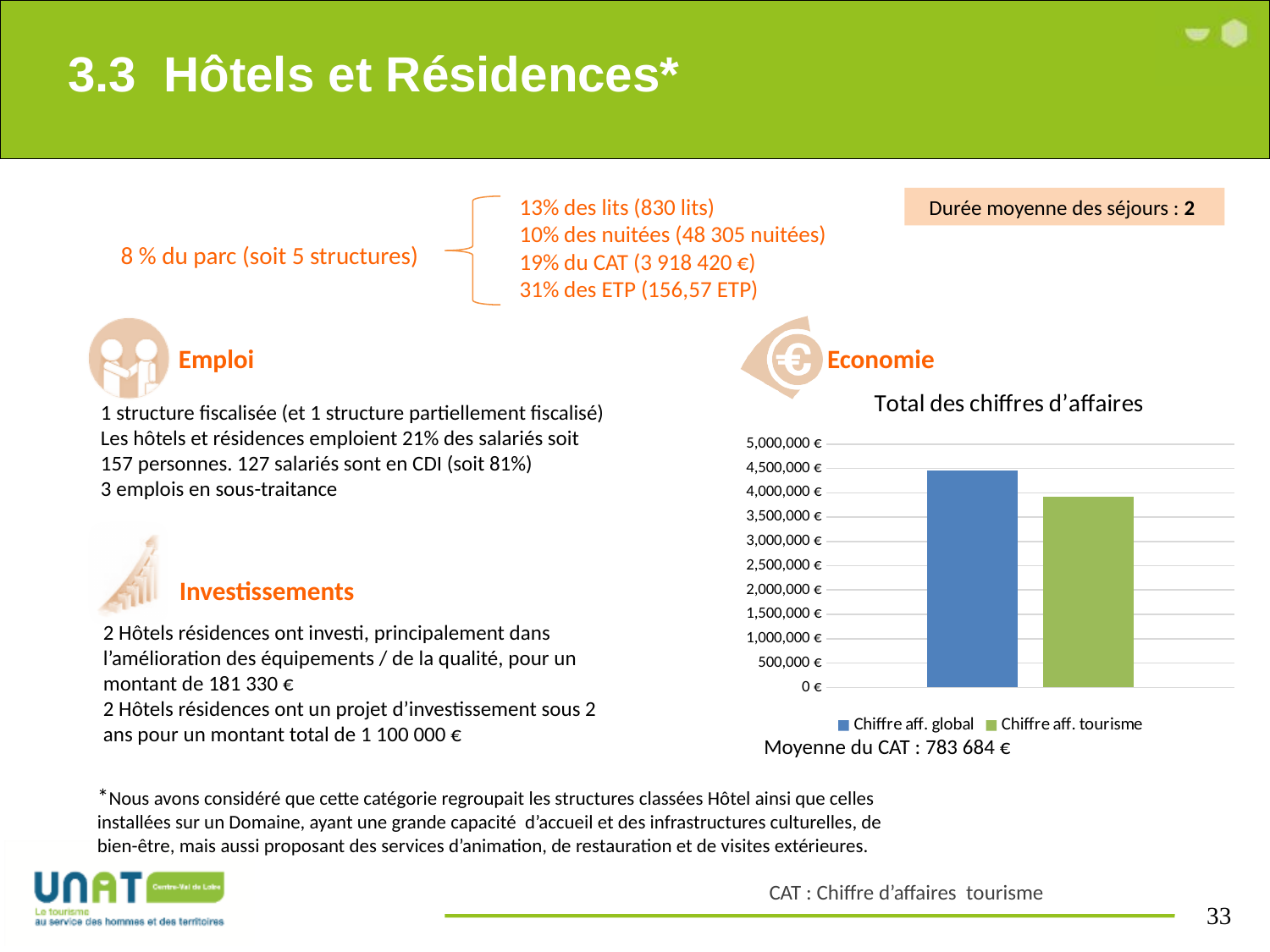
What colour is the bar for Chiffre aff. tourisme in the chart? green Which is larger in the chart: Chiffre aff. global or Chiffre aff. tourisme? Chiffre aff. global Is the value for Chiffre aff. tourisme greater or less than 4,000,000 €? less Do the bar values rise or fall from left to right in the chart? fall Which series has the lowest bar in the chart? Chiffre aff. tourisme Which series has the highest bar in the chart? Chiffre aff. global Is the value for Chiffre aff. tourisme greater or less than 3,500,000 €? greater What kind of chart is shown under 'Economie' on the slide? bar chart Is the value for Chiffre aff. global greater or less than 4,000,000 €? greater How many bars are plotted in the chart? 2 How many series does the legend of the chart list? 2 What is the title of the chart on the slide? Total des chiffres d'affaires